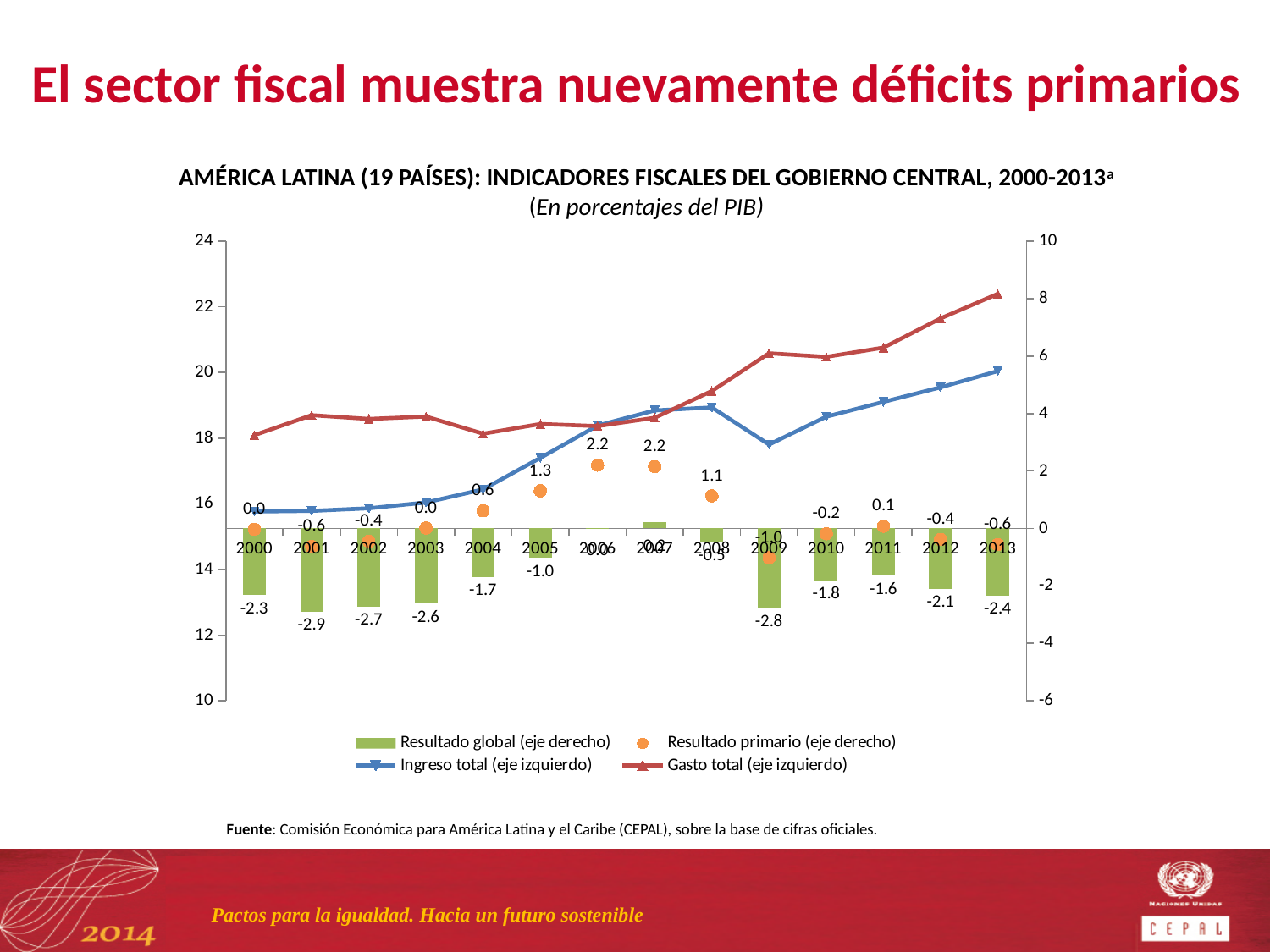
How many series does the legend list? 4 Does Gasto total (eje izquierdo) generally rise or fall from 2000 to 2013? rise What is the difference between Resultado global in 2001 and in 2013? 0.5 Is the value of Gasto total (eje izquierdo) for 2013 greater or less than 22? greater In which year is Resultado global (eje derecho) lowest? 2001 How many years are shown on the x axis? 14 Which is larger, Resultado global in 2004 or in 2010? 2004 What is the value of Resultado primario (eje derecho) for 2005? 1.3 Is the value of Ingreso total (eje izquierdo) for 2009 greater or less than 18? less What is the value of Resultado global (eje derecho) for 2001? -2.9 In which year is Resultado primario (eje derecho) lowest? 2009 What is the value of Resultado global (eje derecho) for 2013? -2.4